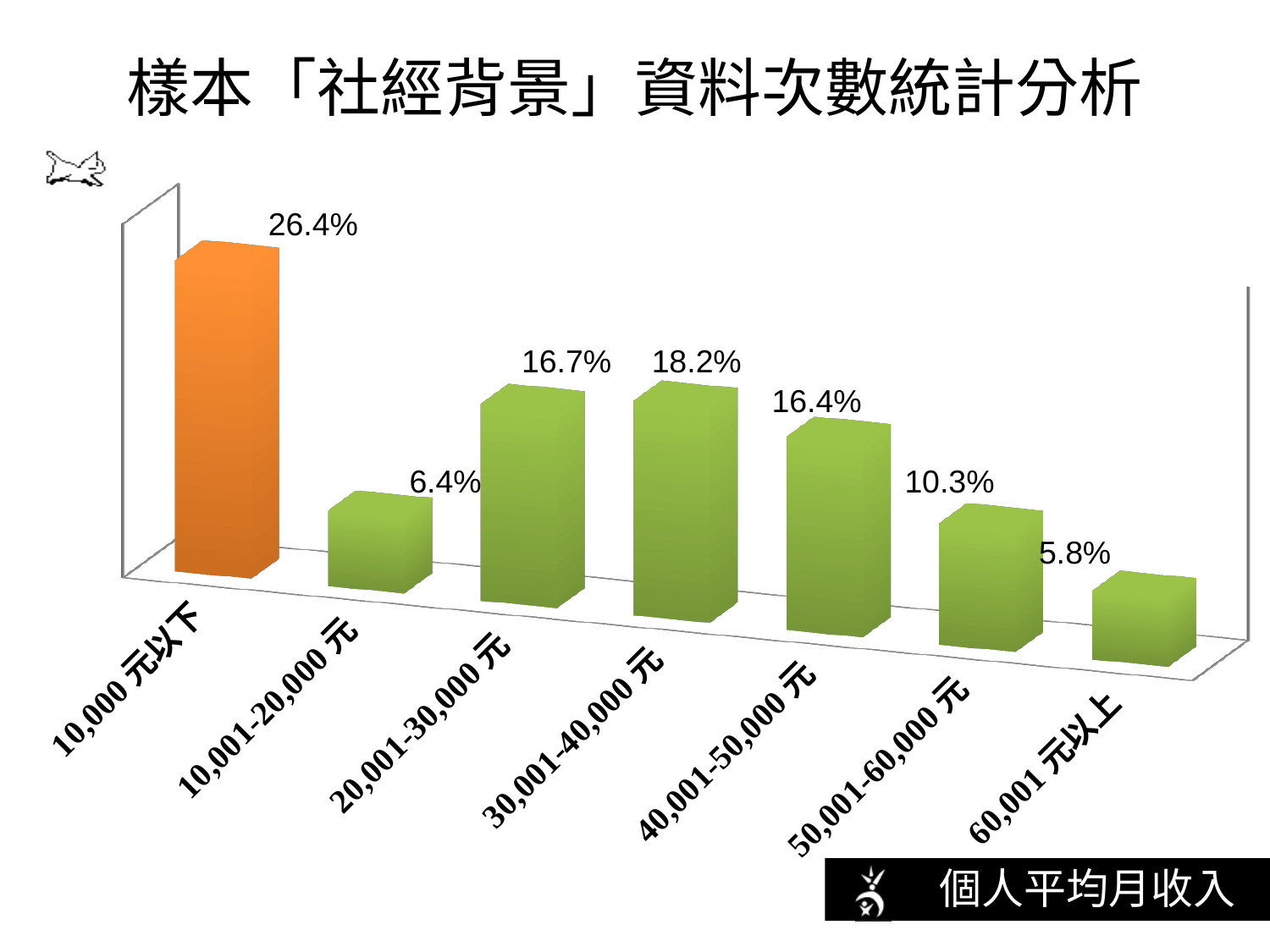
What is the value for 50,001-60,000元? 10.3% What is the value for 10,000元以下? 26.4% What is the value for 30,001-40,000元? 18.2% Which category has the highest value? 10,000元以下 What is the value for 60,001元以上? 5.8% What is the difference between the values for 10,000元以下 and 10,001-20,000元? 20.0% What kind of chart is this? Bar chart What is the title of the slide? 樣本「社經背景」資料次數統計分析 Which is larger, the value for 20,001-30,000元 or the value for 40,001-50,000元? 20,001-30,000元 How many categories are shown in the chart? 7 Which bar is coloured orange rather than green? 10,000元以下 Which category has the lowest value? 60,001元以上